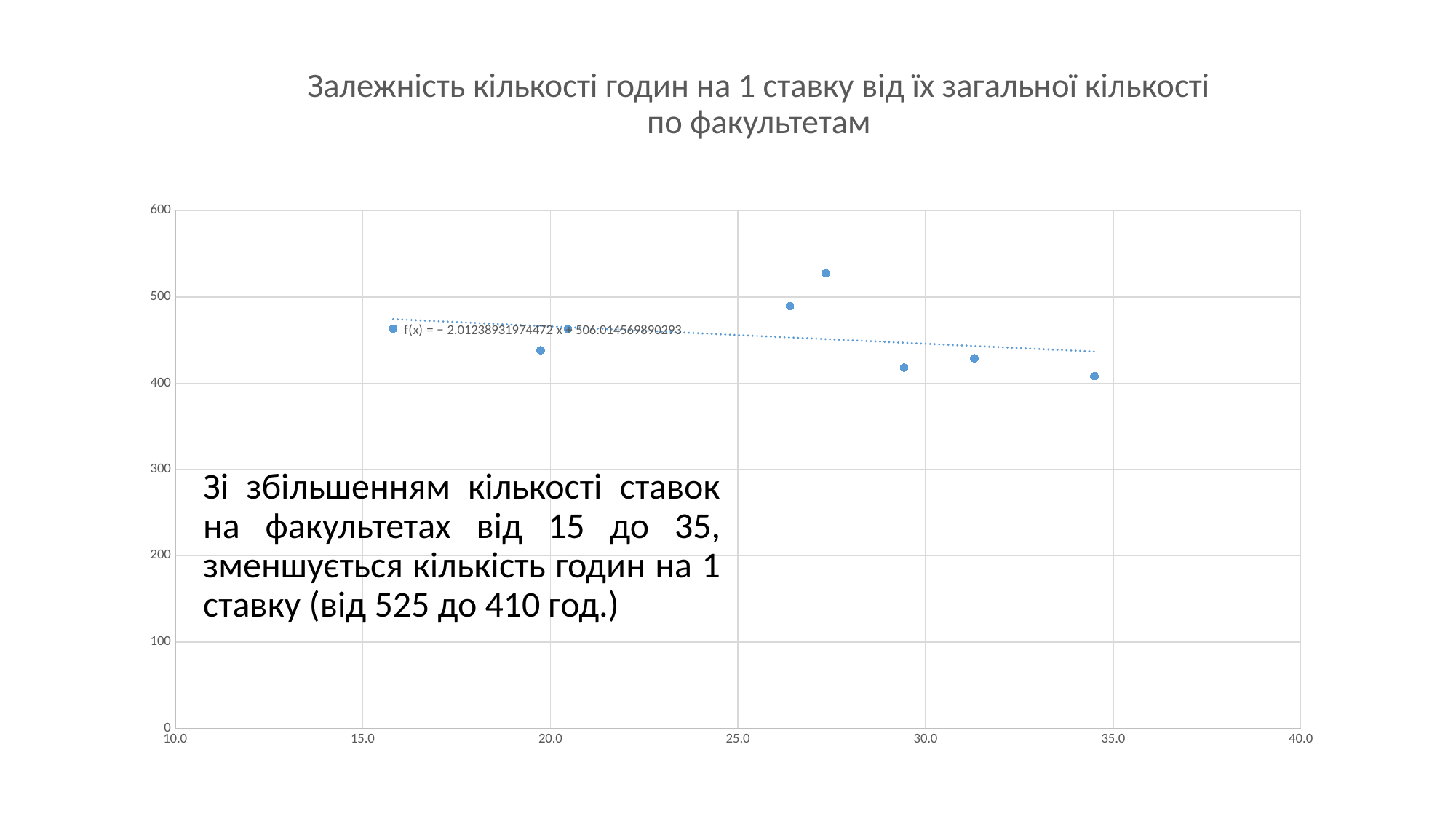
Is the slope of the trendline positive or negative? negative How many data points are plotted on the chart? 8 Is the value of the point plotted at about x = 26.3 greater or less than 400? greater What kind of chart is shown on the slide? scatter chart What is the maximum value shown on the horizontal axis? 40.0 According to the dotted trendline, do the values rise or fall as the x value increases? fall What is the slope coefficient shown in the trendline equation on the chart? −2.01238931974472 Is the highest plotted point greater or less than 500 on the vertical axis? greater Is the value of the point plotted at about x = 34.5 greater or less than 500? less Which point has the higher value: the one at about x = 27.3 or the one at about x = 29.4? the one at about x = 27.3